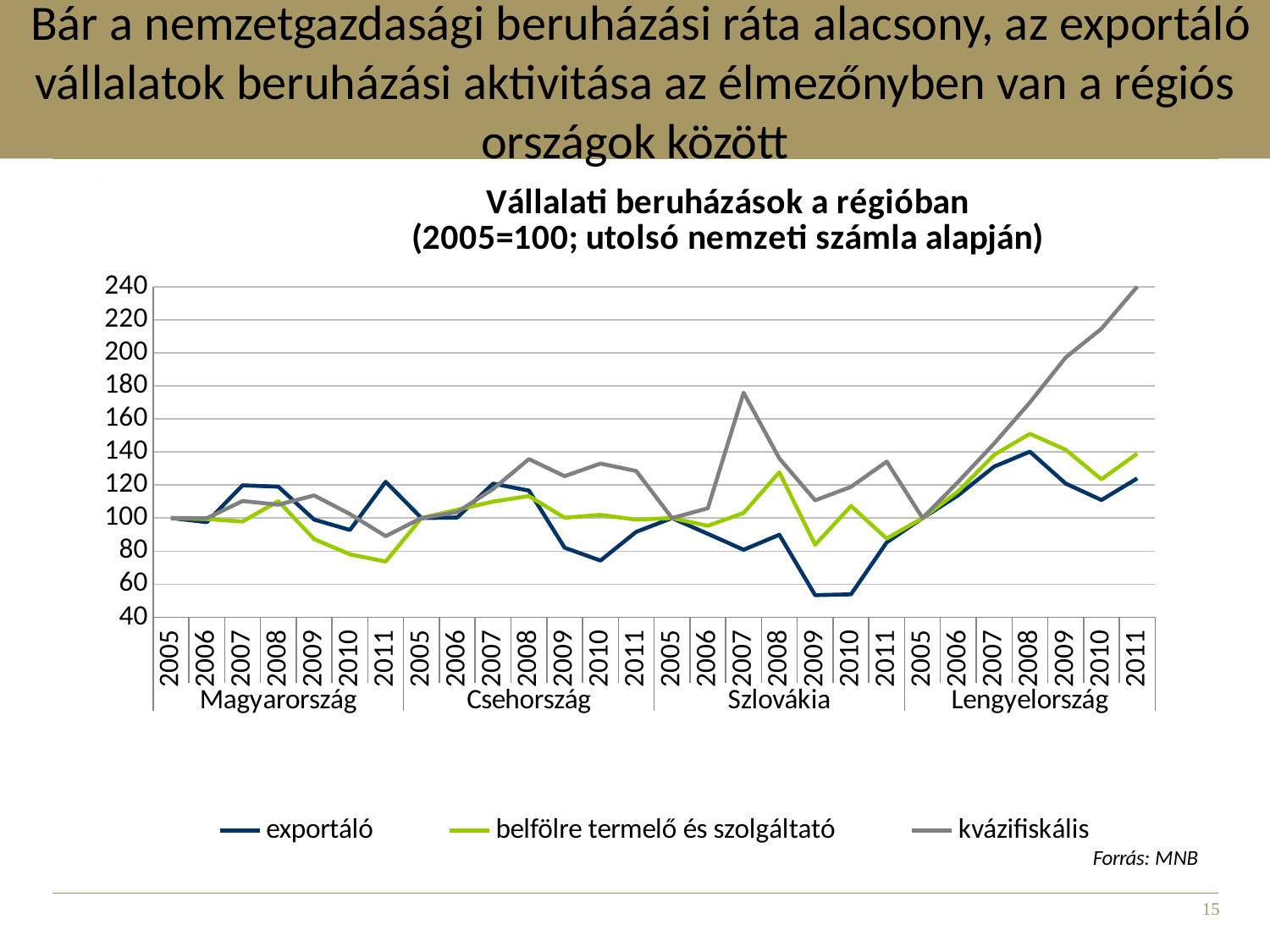
Is the value of the kvázifiskális series for Lengyelország in 2011 greater or less than 220? greater What is the value of the exportáló series for Magyarország in 2005? 100 For Lengyelország in 2011, which series is larger: kvázifiskális or exportáló? kvázifiskális How many countries are shown along the x axis? 4 What is the title of the chart? Vállalati beruházások a régióban (2005=100; utolsó nemzeti számla alapján) Is the value of the kvázifiskális series for Szlovákia in 2007 greater or less than 160? greater Is the value of the exportáló series for Szlovákia in 2009 greater or less than 60? less What kind of chart is shown on the slide? line chart Which series reaches the highest value on the chart? kvázifiskális How many series does the legend list? 3 Which series has the lowest value on the chart? exportáló Does the kvázifiskális series for Lengyelország rise or fall from 2005 to 2011? rise